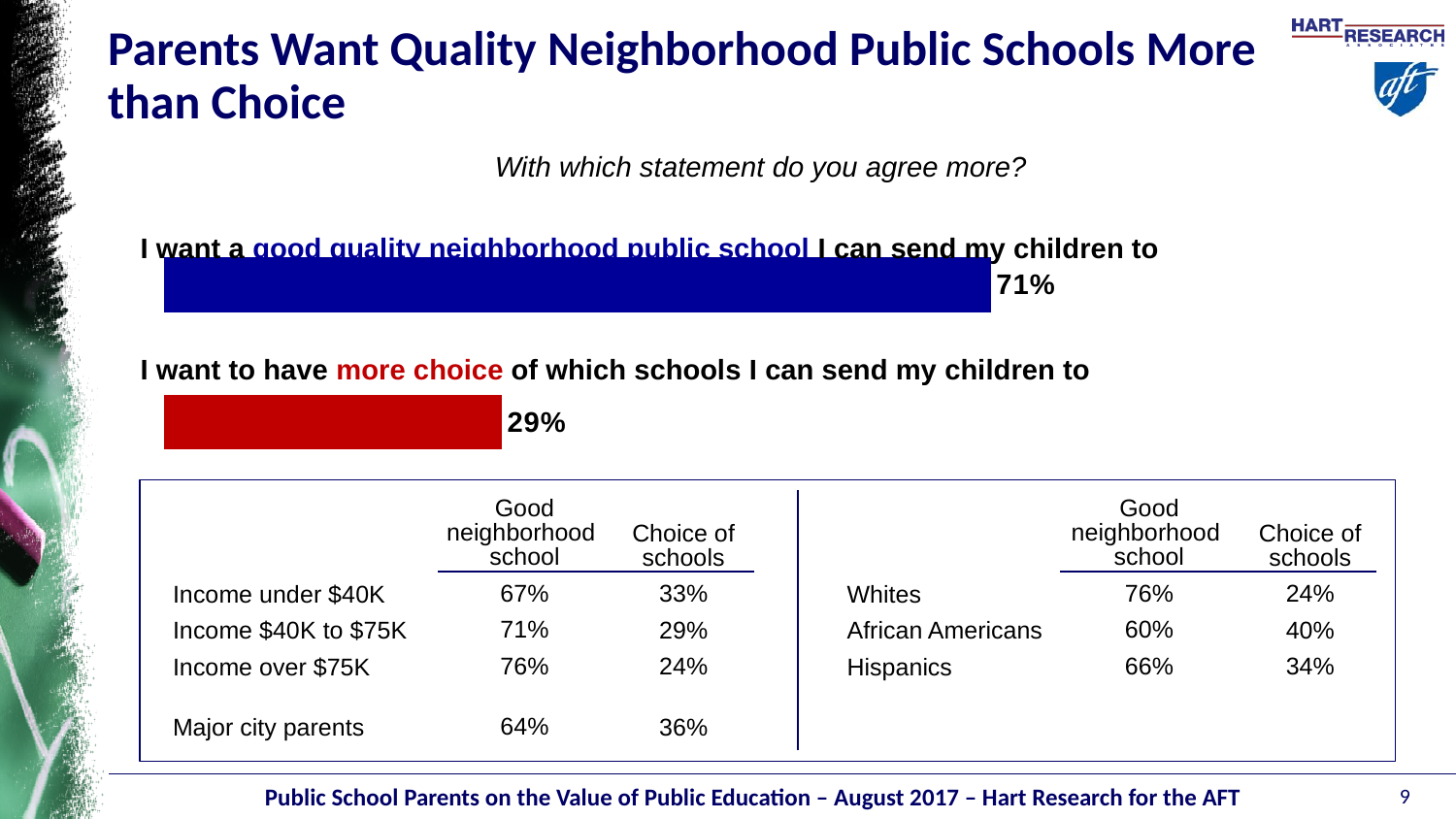
Which statement has the lower share of agreement in the bar chart? I want to have more choice of which schools I can send my children to What is the difference in percentage points between the good quality neighborhood public school bar and the more choice bar? 42 What colour is the bar for the good quality neighborhood public school statement? blue What kind of chart is used to show the agreement with the two statements? bar chart What is the total of the two bar values in the chart? 100% How many bars are shown in the chart? 2 What percentage of parents agree more with wanting a good quality neighborhood public school? 71% What colour is the bar for the more choice statement? red Which statement has the higher share of agreement in the bar chart? I want a good quality neighborhood public school I can send my children to What percentage of parents agree more with wanting more choice of which schools they can send their children to? 29% Is the value for the more choice statement larger or smaller than the value for the good quality neighborhood public school statement? smaller